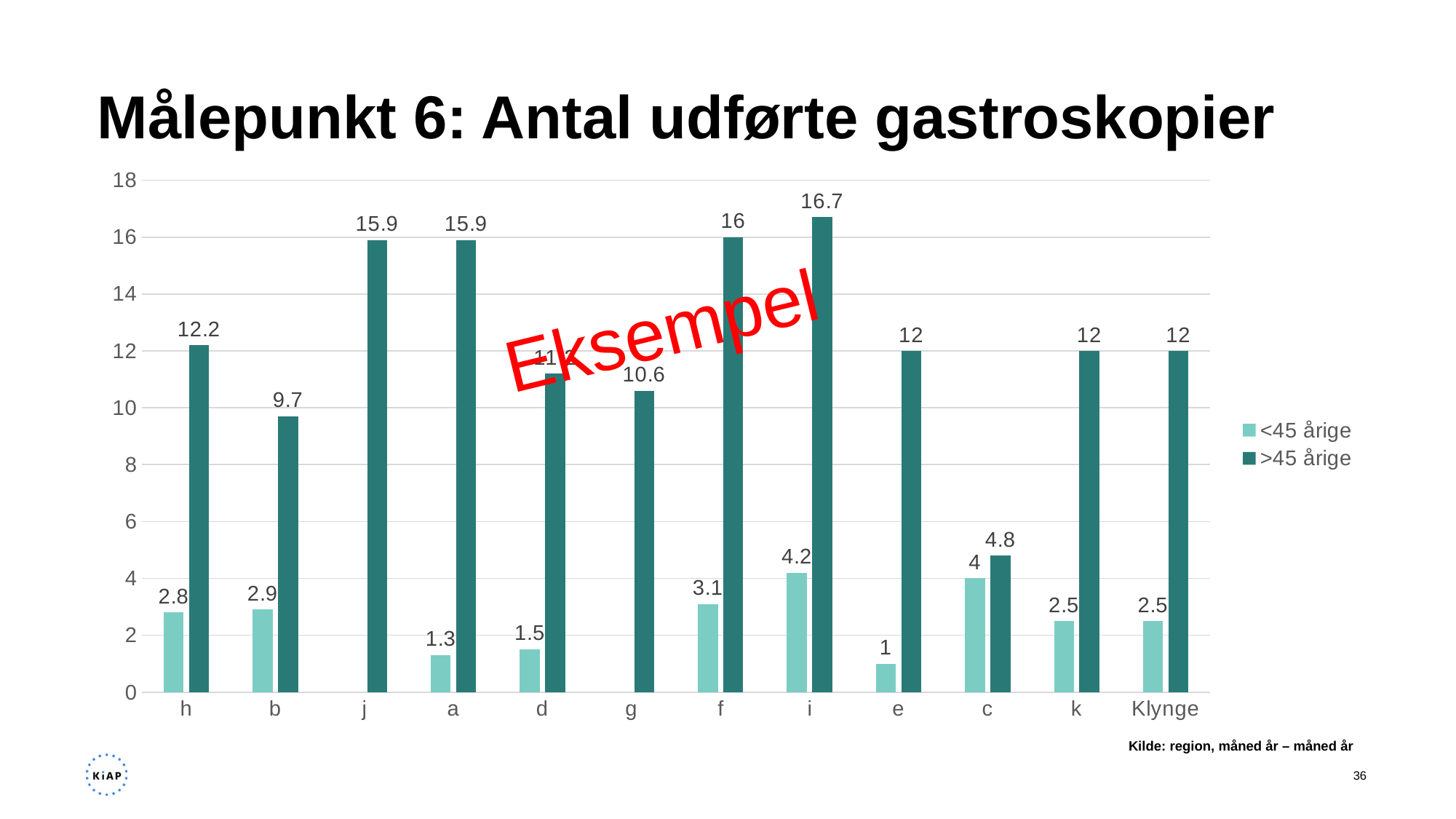
What is the difference between the >45 årige values for i and f? 0.7 Which is larger: the <45 årige value for c or for i? i How many categories are shown on the x axis? 12 What is the value for >45 årige for Klynge? 12 What is the value for >45 årige for category i? 16.7 Which category has the lowest value for <45 årige? e What is the value for <45 årige for category h? 2.8 Which category has the lowest value for >45 årige? c How many series does the legend list? 2 What kind of chart is shown on the slide? bar chart Is the value for >45 årige for category g greater or less than 10? greater Which category has the highest value for >45 årige? i